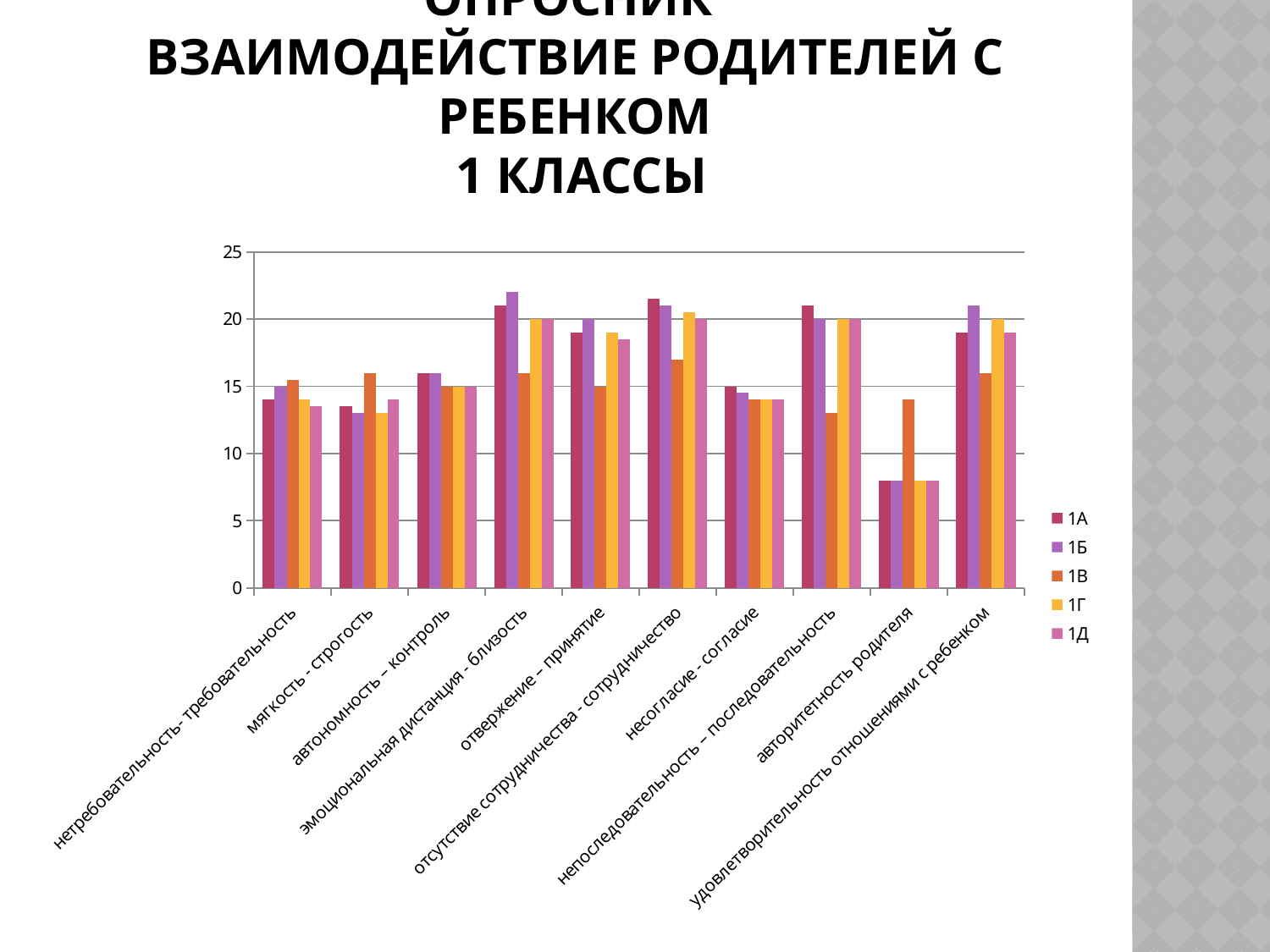
How many series does the legend list? 5 In the category 'мягкость - строгость', is the value for 1В larger or smaller than the value for 1Б? larger In the category 'авторитетность родителя', which series has the highest value? 1В Is the value for 1Б in the category 'эмоциональная дистанция - близость' greater or less than 20? greater What kind of chart is shown on the slide? bar chart In the category 'эмоциональная дистанция - близость', which series has the lowest value? 1В Is the value for 1В in the category 'непоследовательность – последовательность' greater or less than 15? less What is the value for 1Б in the category 'непоследовательность – последовательность'? 20 How many categories are shown along the x axis? 10 Which series are listed in the legend? 1А, 1Б, 1В, 1Г, 1Д Is the value for 1А in the category 'авторитетность родителя' greater or less than 10? less